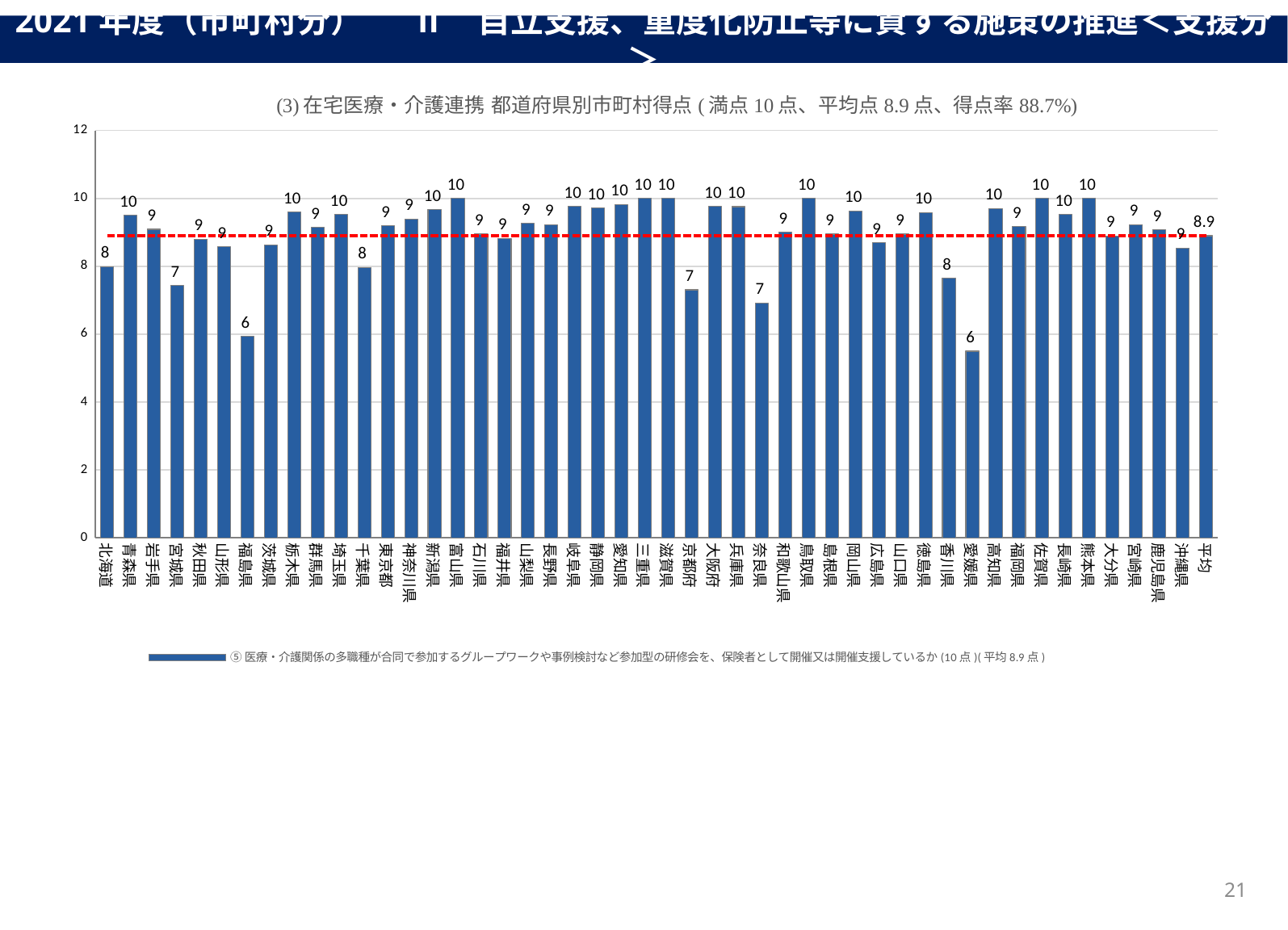
What is the value shown for 香川県? 8 What is the value shown for 奈良県? 7 What is the difference between the values for 青森県 and 北海道? 2 How many series does the legend list? 1 Which has the larger value, 福島県 or 茨城県? 茨城県 According to the chart title, what is the 得点率 (score rate)? 88.7% What type of chart is shown on the slide? bar chart How many bars are plotted in the chart, including 平均? 48 Is the value for 京都府 greater or less than 8? less What is the value shown for 北海道? 8 What is the value shown for 平均 (the last bar)? 8.9 Which has the larger value, 青森県 or 宮城県? 青森県